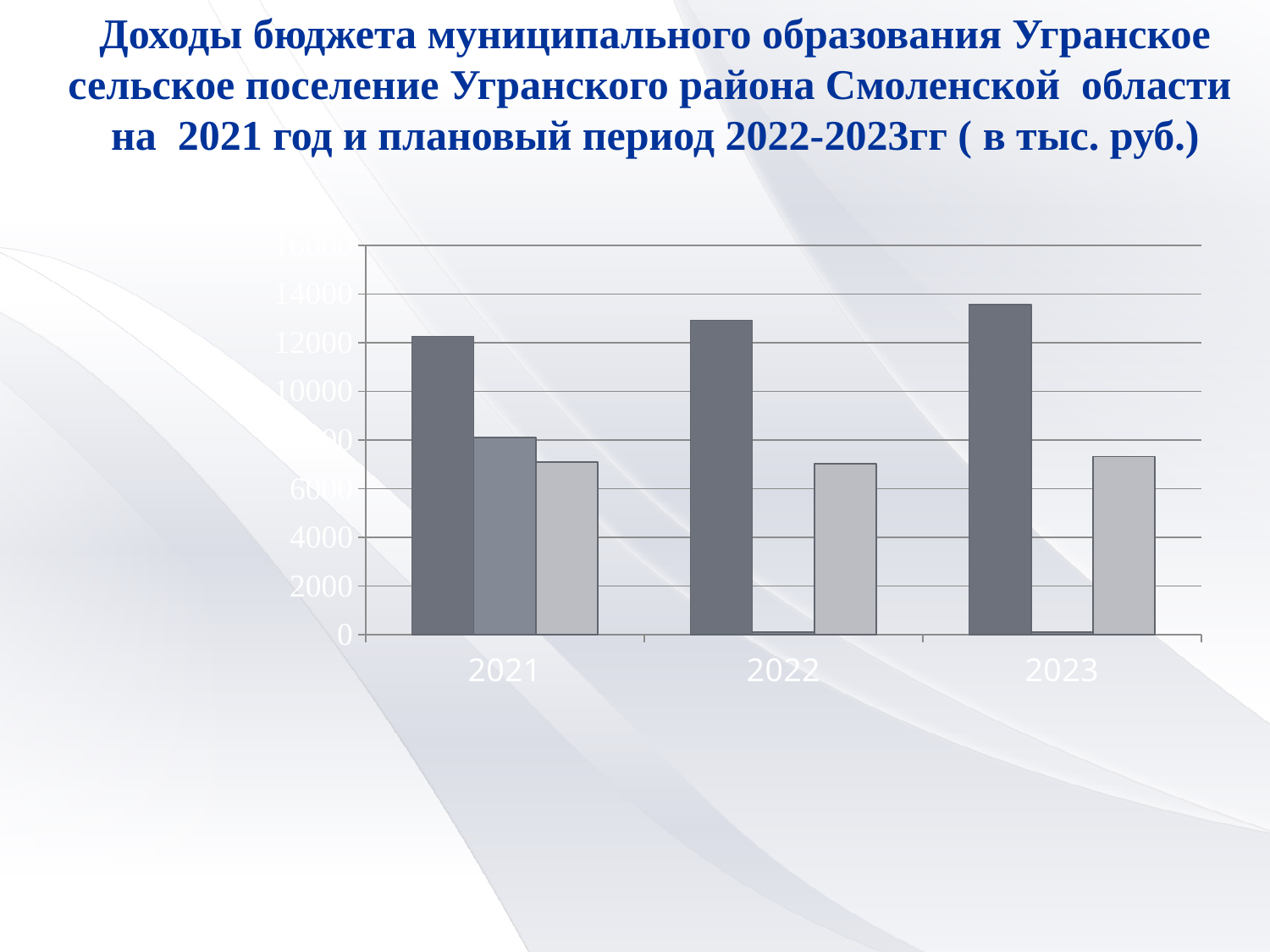
In what units are the values in the chart expressed, according to the slide title? тыс. руб. How many year categories are shown on the x axis of the chart? 3 Do the values of the darkest (first) bars rise or fall from 2021 to 2023? rise Is the value of the middle (second) bar for 2021 greater or less than 6000? greater Which is larger: the middle (second) bar for 2021 or the middle (second) bar for 2022? 2021 Is the value of the darkest (first) bar for 2021 greater or less than 12000? greater Is the value of the darkest (first) bar for 2023 greater or less than 14000? less For which year is the darkest (first) bar the highest? 2023 What kind of chart is shown on the slide? bar chart How many bars are plotted for each year in the chart? 3